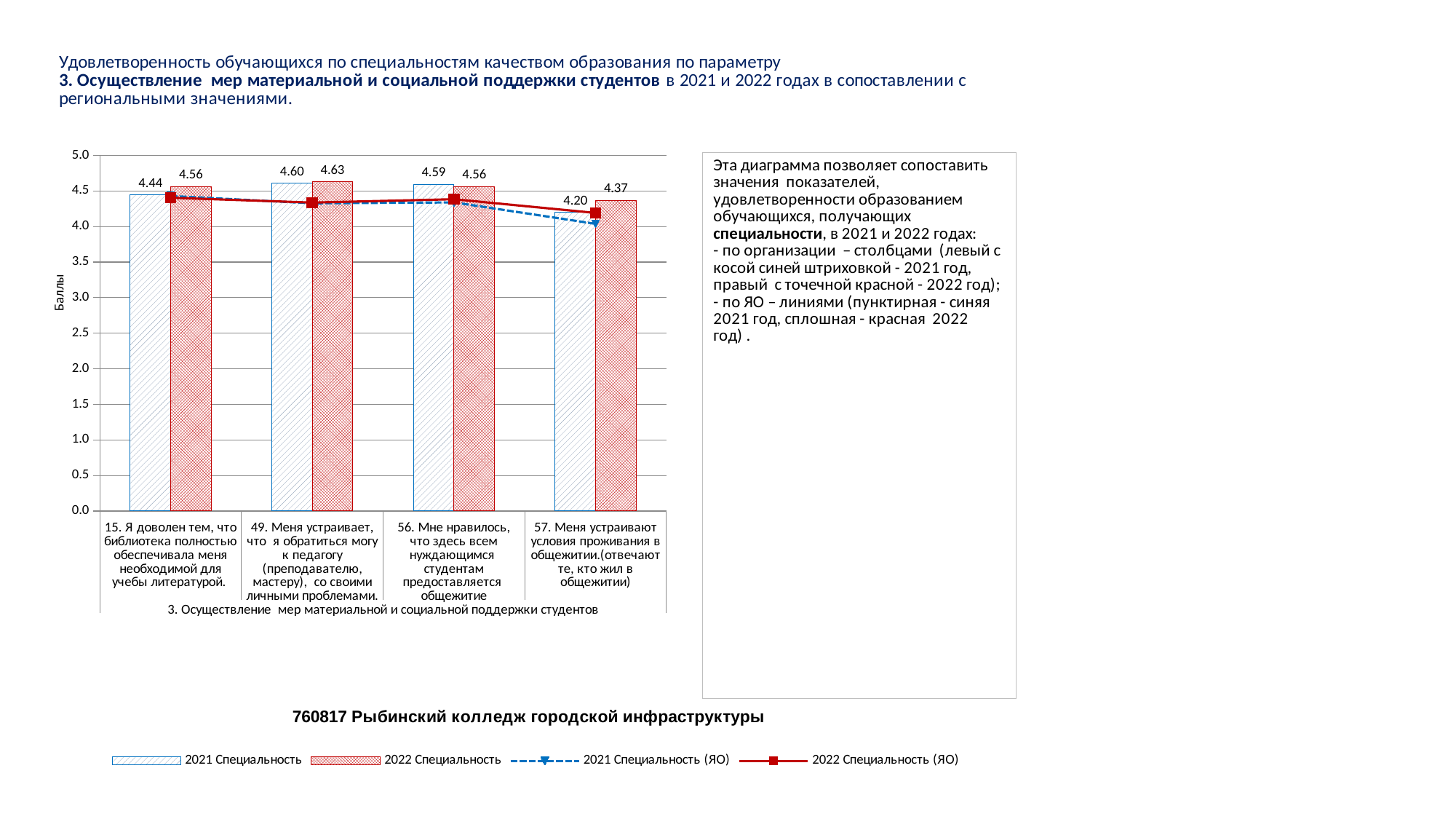
Which category has the lowest 2021 Специальность value? 57. Меня устраивают условия проживания в общежитии For question 56 (dormitory provided to students in need), which is larger: the 2021 or the 2022 Специальность value? 2021 (4.59) What is the value of the 2021 Специальность bar for question 15 (library literature)? 4.44 What is the value of the 2022 Специальность bar for question 57 (dormitory living conditions)? 4.37 Is the 2021 Специальность (ЯО) line value for question 57 greater or less than 4.5? less What is the value of the 2022 Специальность bar for question 49 (approaching a teacher with personal problems)? 4.63 Which category has the highest 2022 Специальность value? 49. Меня устраивает, что я обратиться могу к педагогу How many categories (questions) are shown on the x axis? 4 What type of chart is shown on the slide? Combined bar and line chart What is the difference between the 2022 and 2021 Специальность values for question 57? 0.17 How many series does the legend list? 4 What is the label of the y axis? Баллы